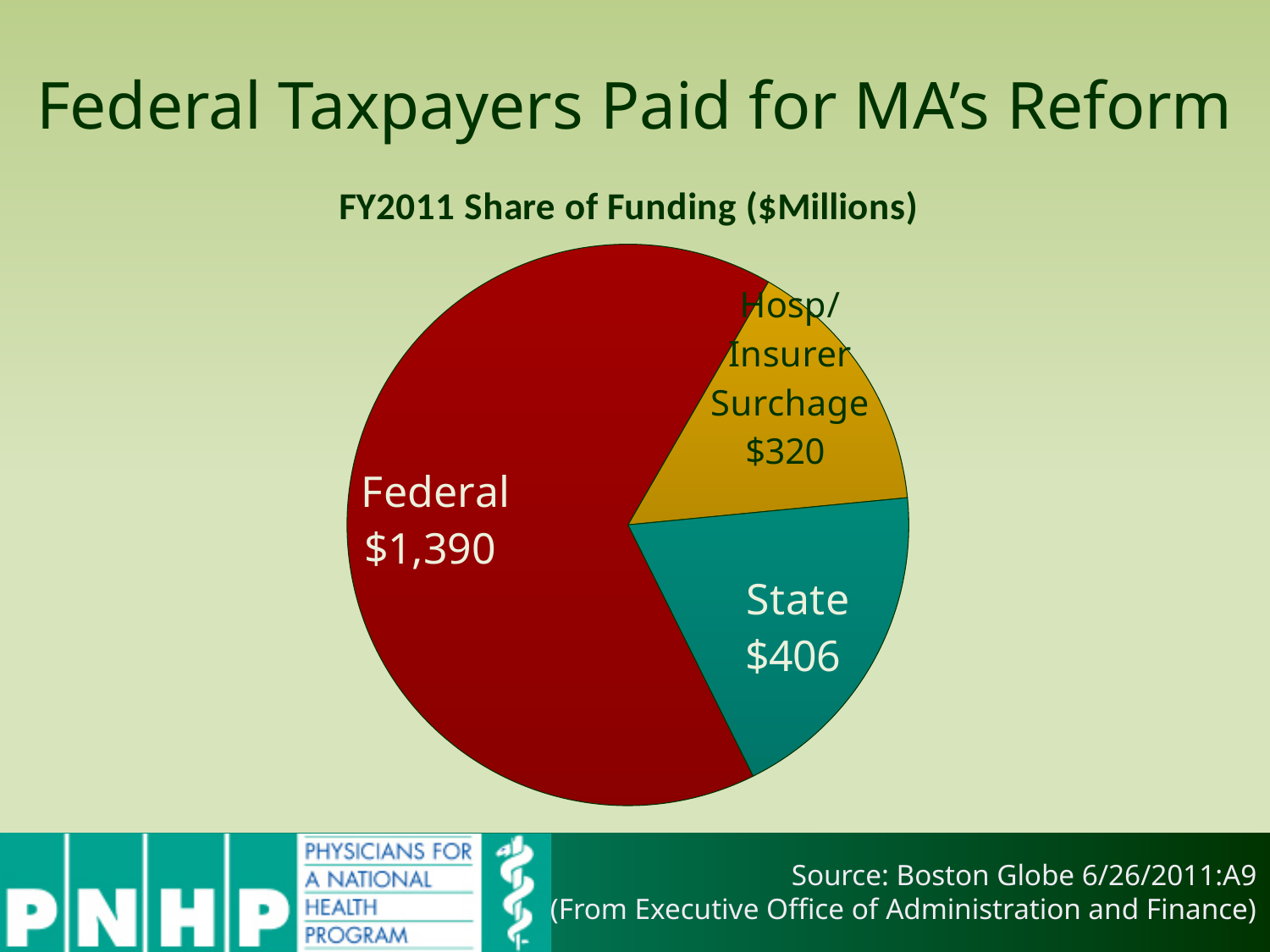
What is the total of all three slices in the pie chart? $2,116 Which slice of the pie chart is the largest? Federal What is the difference between the Federal value and the State value? $984 What is the value for State in the pie chart? $406 What is the value for Hosp/Insurer Surchage in the pie chart? $320 What is the value for Federal in the pie chart? $1,390 How many slices does the pie chart have? 3 What type of chart is shown on the slide? Pie chart Which slice of the pie chart is the smallest? Hosp/Insurer Surchage Which is larger, the State value or the Hosp/Insurer Surchage value? State What is the difference between the State value and the Hosp/Insurer Surchage value? $86 What is the title of the pie chart? FY2011 Share of Funding ($Millions)